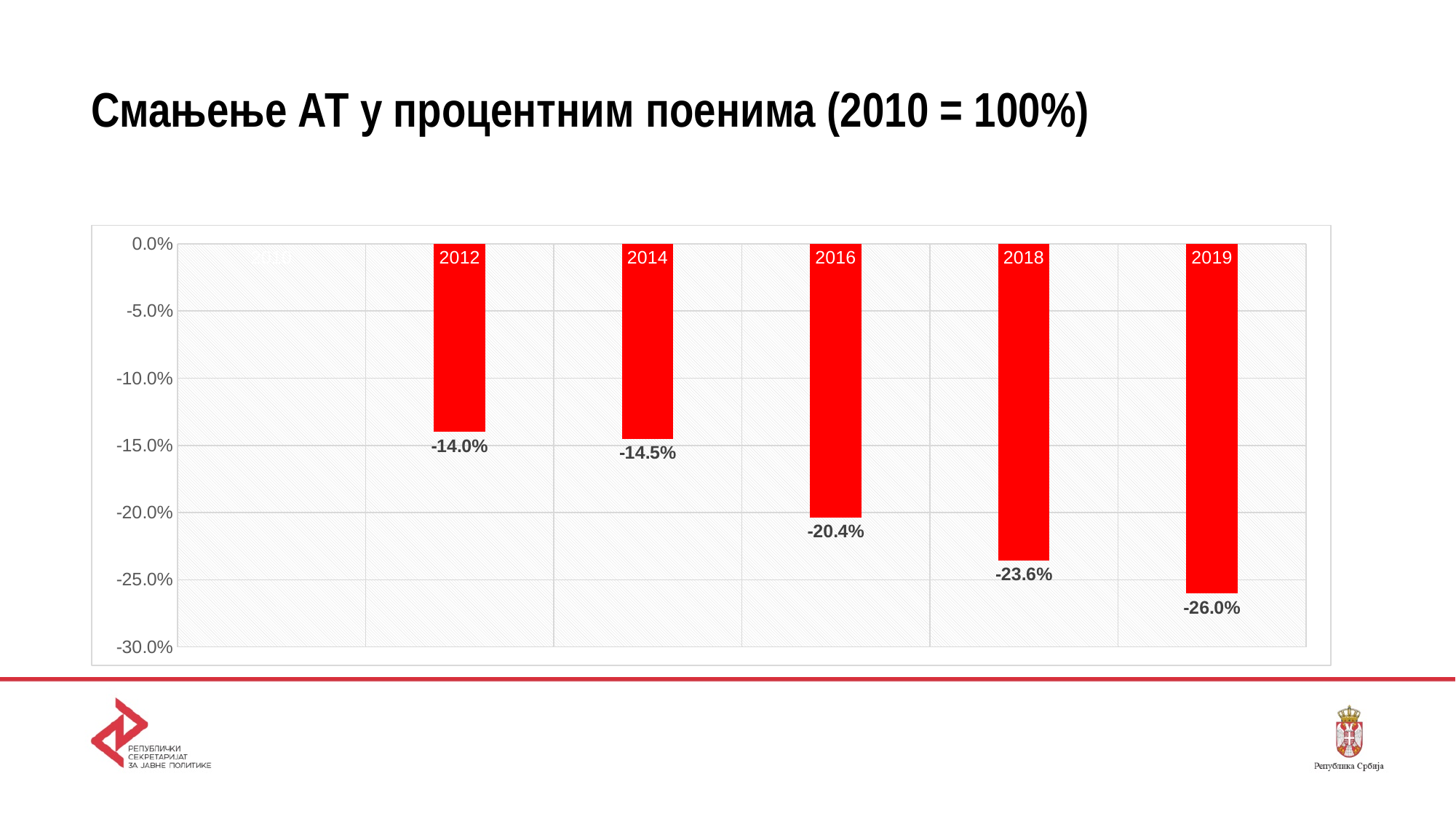
What is the value shown for 2018? -23.6% Do the values rise or fall from 2012 to 2019? Fall What is the value shown for 2016? -20.4% Which is more negative, the value for 2014 or the value for 2016? 2016 What is the value shown for 2012? -14.0% What is the value shown for 2019? -26.0% What is the difference between the values for 2016 and 2018? 3.2 percentage points What is the difference between the values for 2012 and 2019? 12.0 percentage points How many bars are plotted on the chart? 5 Which year has the lowest (most negative) value? 2019 Which year with a bar has the highest (least negative) value? 2012 What kind of chart is shown on the slide? Bar chart